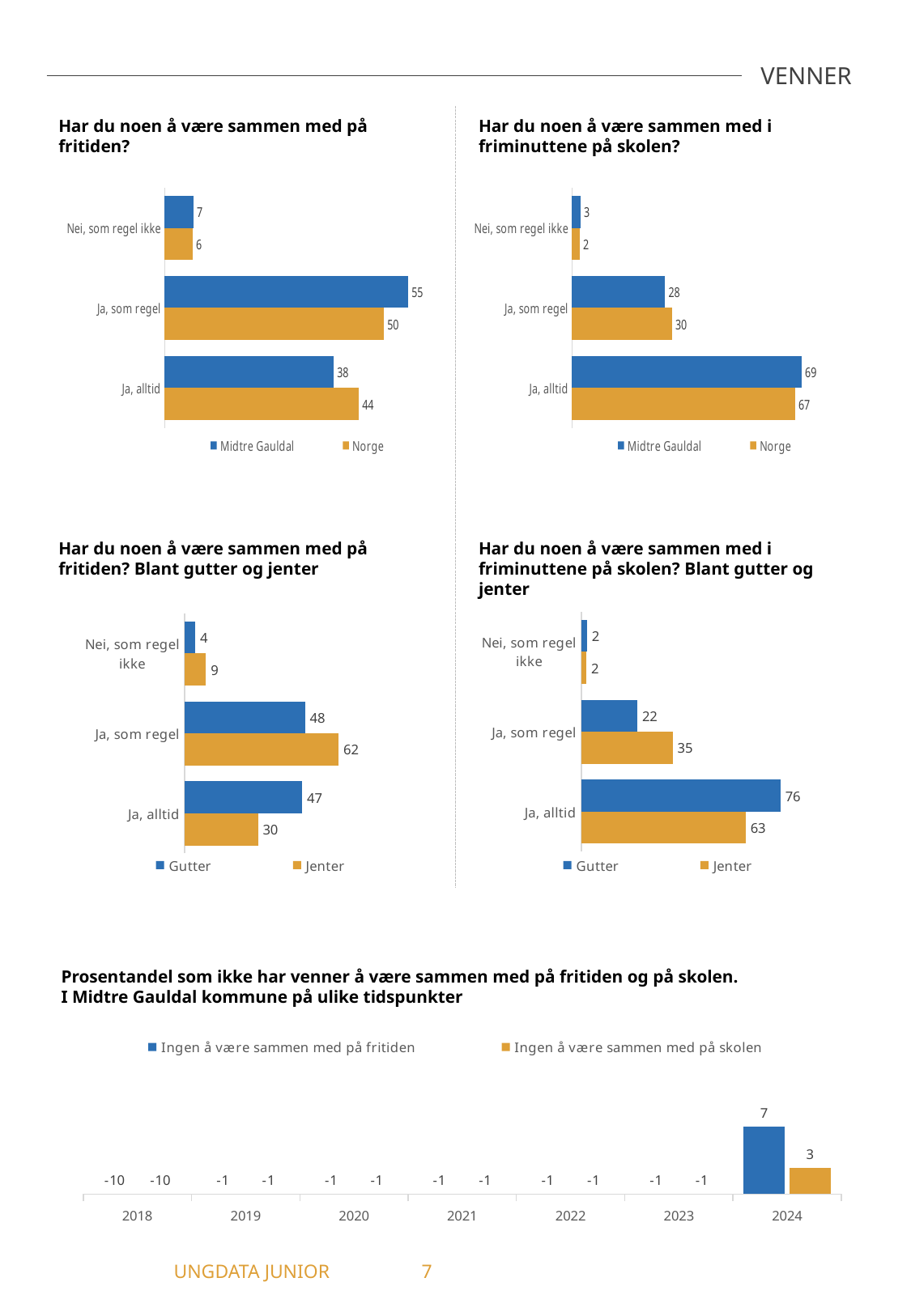
In the top-left chart 'Har du noen å være sammen med på fritiden?', what is the difference between Norge and Midtre Gauldal for 'Ja, alltid'? 6 In the top-left chart 'Har du noen å være sammen med på fritiden?', what is the value for Midtre Gauldal for 'Ja, som regel'? 55 In the middle-left chart 'Har du noen å være sammen med på fritiden? Blant gutter og jenter', what is the difference between Gutter and Jenter for 'Ja, alltid'? 17 In the middle-right chart 'Har du noen å være sammen med i friminuttene på skolen? Blant gutter og jenter', which category has the lowest value for Jenter? Nei, som regel ikke In the middle-right chart 'Har du noen å være sammen med i friminuttene på skolen? Blant gutter og jenter', what is the value for Gutter for 'Ja, alltid'? 76 In the top-right chart 'Har du noen å være sammen med i friminuttene på skolen?', what is the value for Norge for 'Ja, som regel'? 30 How many series does the legend list in the middle-right chart 'Har du noen å være sammen med i friminuttene på skolen? Blant gutter og jenter'? 2 In the top-right chart 'Har du noen å være sammen med i friminuttene på skolen?', which is larger for 'Nei, som regel ikke': Midtre Gauldal or Norge? Midtre Gauldal In the bottom chart 'Prosentandel som ikke har venner å være sammen med på fritiden og på skolen', what is the value for 'Ingen å være sammen med på fritiden' in 2024? 7 What kind of chart is the bottom chart 'Prosentandel som ikke har venner å være sammen med på fritiden og på skolen'? Bar chart In the middle-left chart 'Har du noen å være sammen med på fritiden? Blant gutter og jenter', what is the value for Jenter for 'Ja, som regel'? 62 In the top-right chart 'Har du noen å være sammen med i friminuttene på skolen?', which category has the highest value for Midtre Gauldal? Ja, alltid